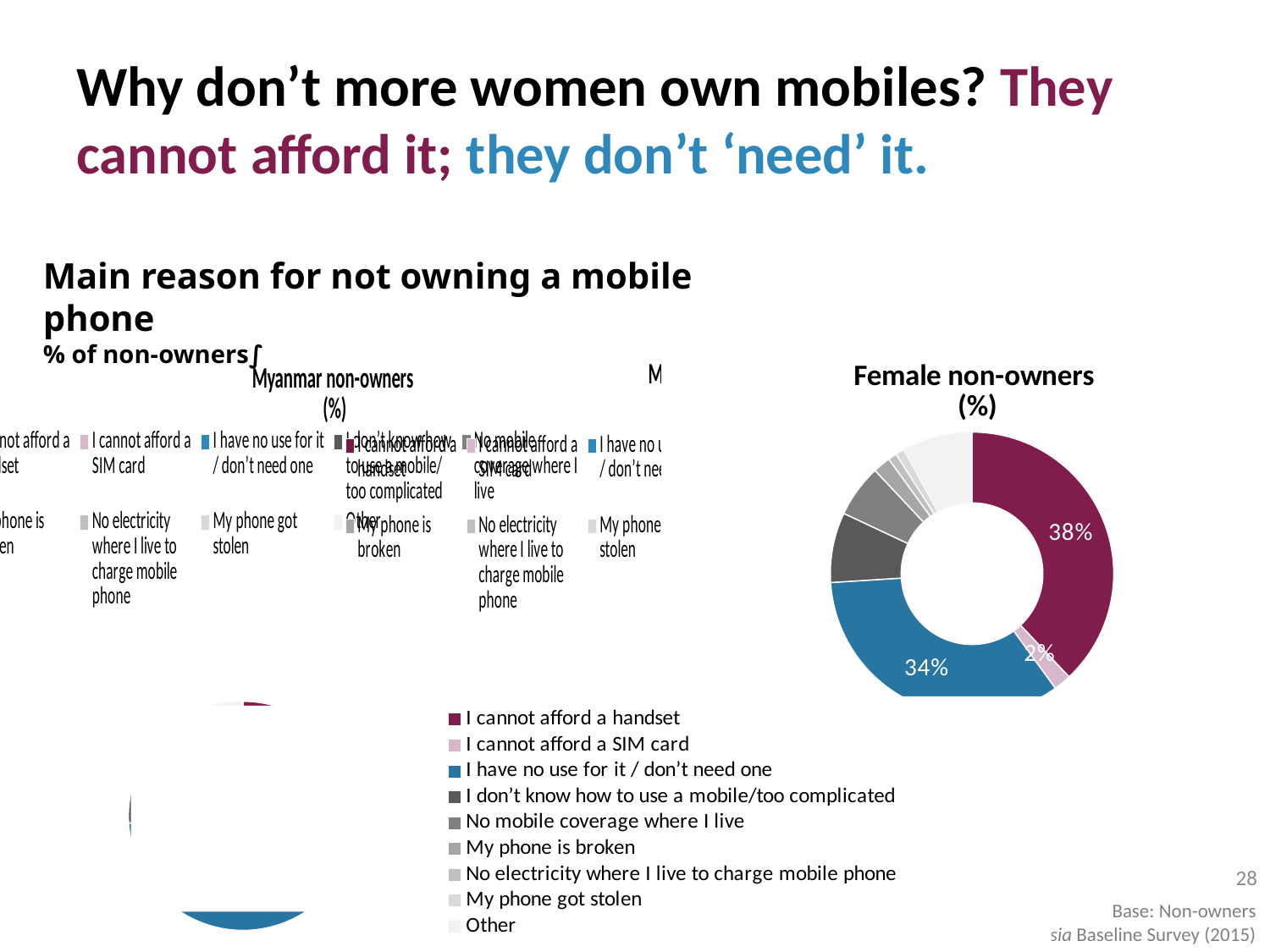
How many entries does the legend below the 'Female non-owners (%)' chart list? 9 In the 'Female non-owners (%)' chart, what share of female non-owners say they have no use for it / don't need one? 34% In the 'Female non-owners (%)' chart, what is the difference between the share for 'I cannot afford a handset' and the share for 'I have no use for it / don't need one'? 4 percentage points In the 'Female non-owners (%)' chart, what share of female non-owners say they cannot afford a handset? 38% In the 'Female non-owners (%)' chart, what share of female non-owners say they cannot afford a SIM card? 2% In the 'Female non-owners (%)' chart, what is the combined share of 'I cannot afford a handset' and 'I have no use for it / don't need one'? 72% In the 'Female non-owners (%)' chart, what colour is the slice for 'I have no use for it / don't need one'? Blue In the 'Female non-owners (%)' chart, which reason has the largest share? I cannot afford a handset What is the title of the donut chart on the right of the slide? Female non-owners (%) What type of chart is the 'Female non-owners (%)' chart? Pie (donut) chart In the 'Female non-owners (%)' chart, which is larger: the share for 'I cannot afford a handset' or the share for 'I cannot afford a SIM card'? I cannot afford a handset